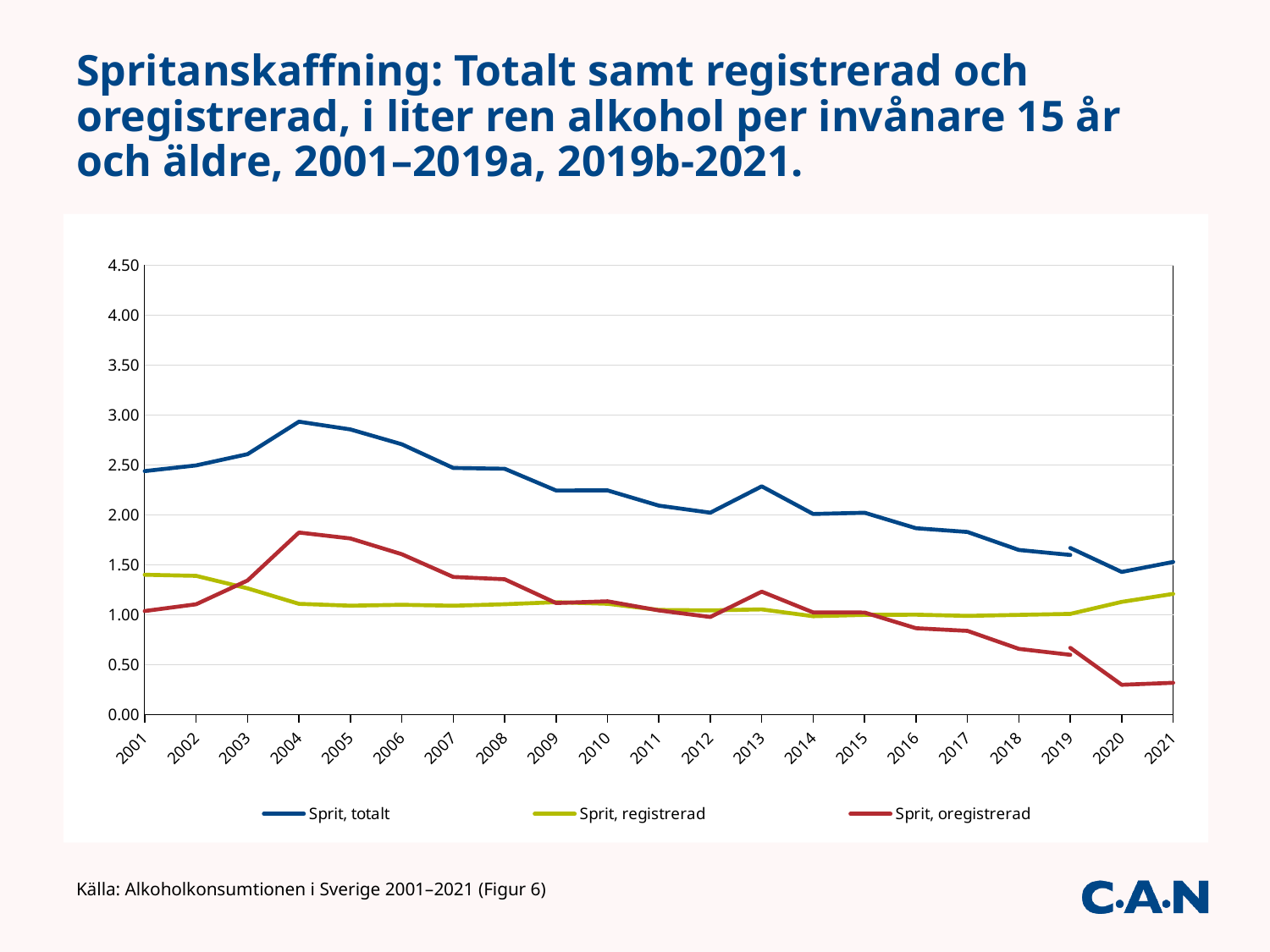
In which year does the Sprit, oregistrerad series reach its highest value? 2004 Is the value for Sprit, totalt in 2004 greater or less than 2.50? greater In 2004, which is larger: Sprit, registrerad or Sprit, oregistrerad? Sprit, oregistrerad Is the value for Sprit, oregistrerad in 2020 greater or less than 0.50? less What kind of chart is shown on the slide? line chart In which year does the Sprit, totalt series reach its lowest value? 2020 Does the Sprit, totalt series overall rise or fall from 2001 to 2021? fall Which series is drawn in red in the chart? Sprit, oregistrerad How many years are shown along the x axis? 21 How many series does the legend list? 3 In which year does the Sprit, totalt series reach its highest value? 2004 Is the value for Sprit, totalt in 2021 greater or less than 2.00? less